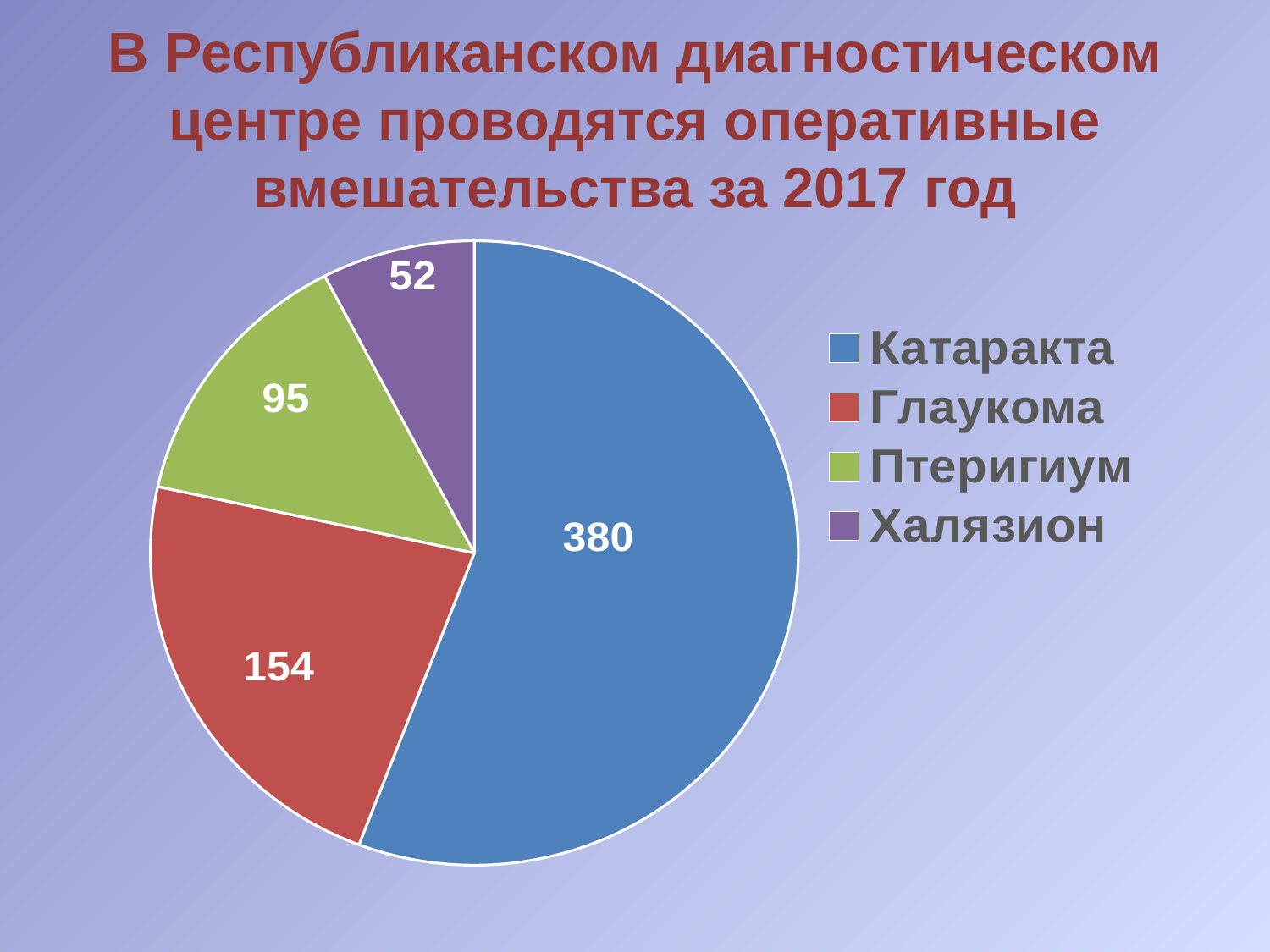
How many slices does the pie chart have? 4 What is the value for Халязион? 52 What colour is the slice for Глаукома? red What is the value for Глаукома? 154 What type of chart is shown on the slide? pie chart Which is larger, the value for Птеригиум or the value for Халязион? Птеригиум What is the value for Птеригиум? 95 Which category has the largest slice? Катаракта What is the value for Катаракта? 380 Which category has the smallest slice? Халязион What is the total of all four slices? 681 What is the difference between the values for Катаракта and Глаукома? 226